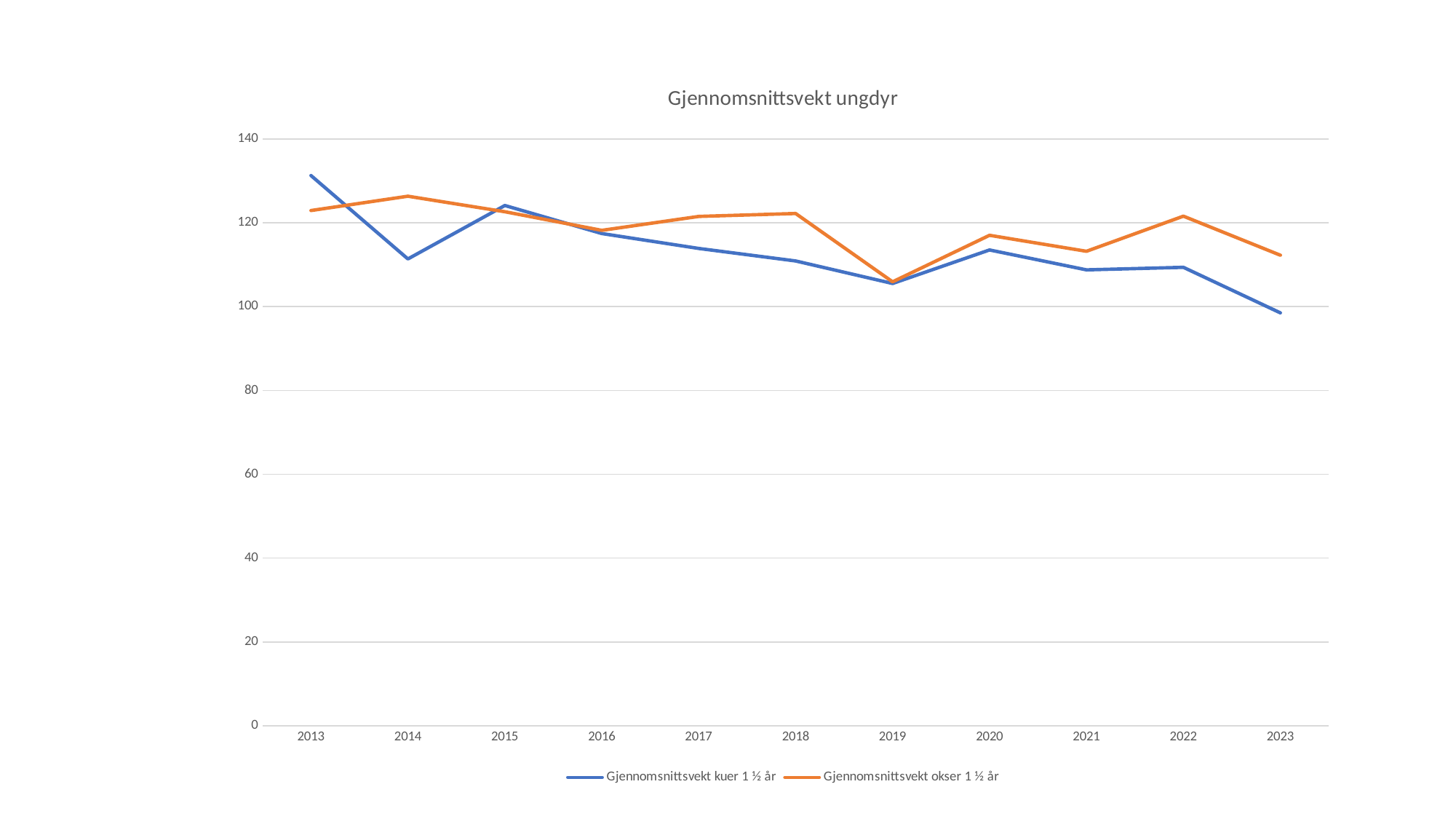
In which year is the value for Gjennomsnittsvekt kuer 1 ½ år highest? 2013 Which series is drawn in orange? Gjennomsnittsvekt okser 1 ½ år How many years are plotted along the x axis? 11 What is the title of the chart? Gjennomsnittsvekt ungdyr Overall, does the value for Gjennomsnittsvekt kuer 1 ½ år rise or fall from 2013 to 2023? fall In which year is the value for Gjennomsnittsvekt okser 1 ½ år lowest? 2019 In 2014, which series has the larger value, Gjennomsnittsvekt kuer 1 ½ år or Gjennomsnittsvekt okser 1 ½ år? Gjennomsnittsvekt okser 1 ½ år In which year is the value for Gjennomsnittsvekt kuer 1 ½ år lowest? 2023 Is the value for Gjennomsnittsvekt okser 1 ½ år in 2014 greater or less than 120? greater How many series does the legend list? 2 What kind of chart is shown on the slide? line chart Is the value for Gjennomsnittsvekt kuer 1 ½ år in 2023 greater or less than 100? less